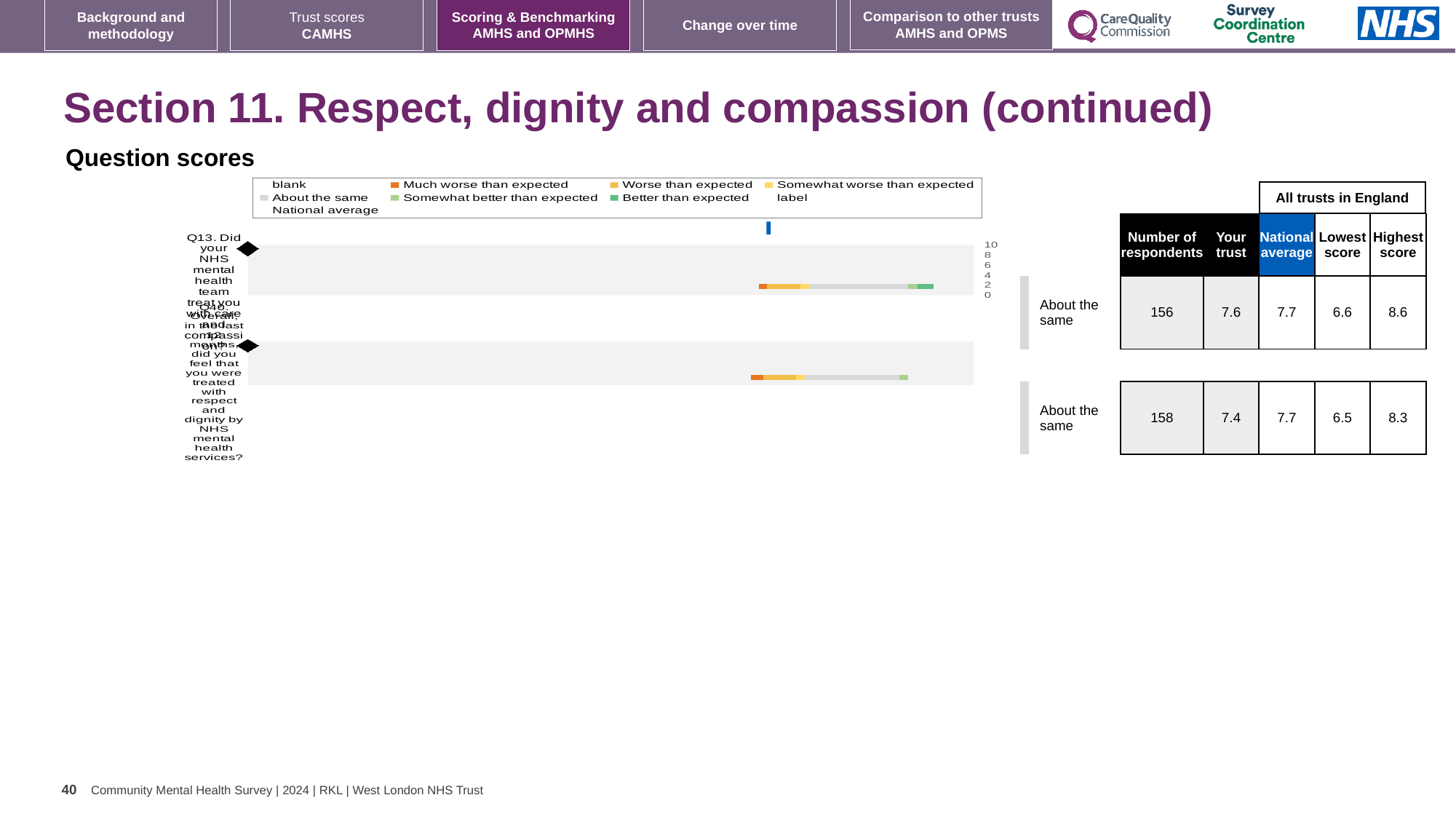
Which question has the higher 'Your trust' score, Q13 or Q10? Q13 What is the difference between the highest score and the lowest score for Q13? 2.0 How many entries does the chart legend list? 9 What is the highest score among all trusts in England for Q10? 8.3 What is the national average score for Q13? 7.7 What benchmark category is shown for Q10? About the same How many respondents answered Q10? 158 How many questions (categories) are plotted in the chart? 2 What kind of chart is shown under 'Question scores'? bar chart What is the 'Your trust' score for Q10? 7.4 What is the 'Your trust' score for Q13? 7.6 What is the lowest score among all trusts in England for Q13? 6.6